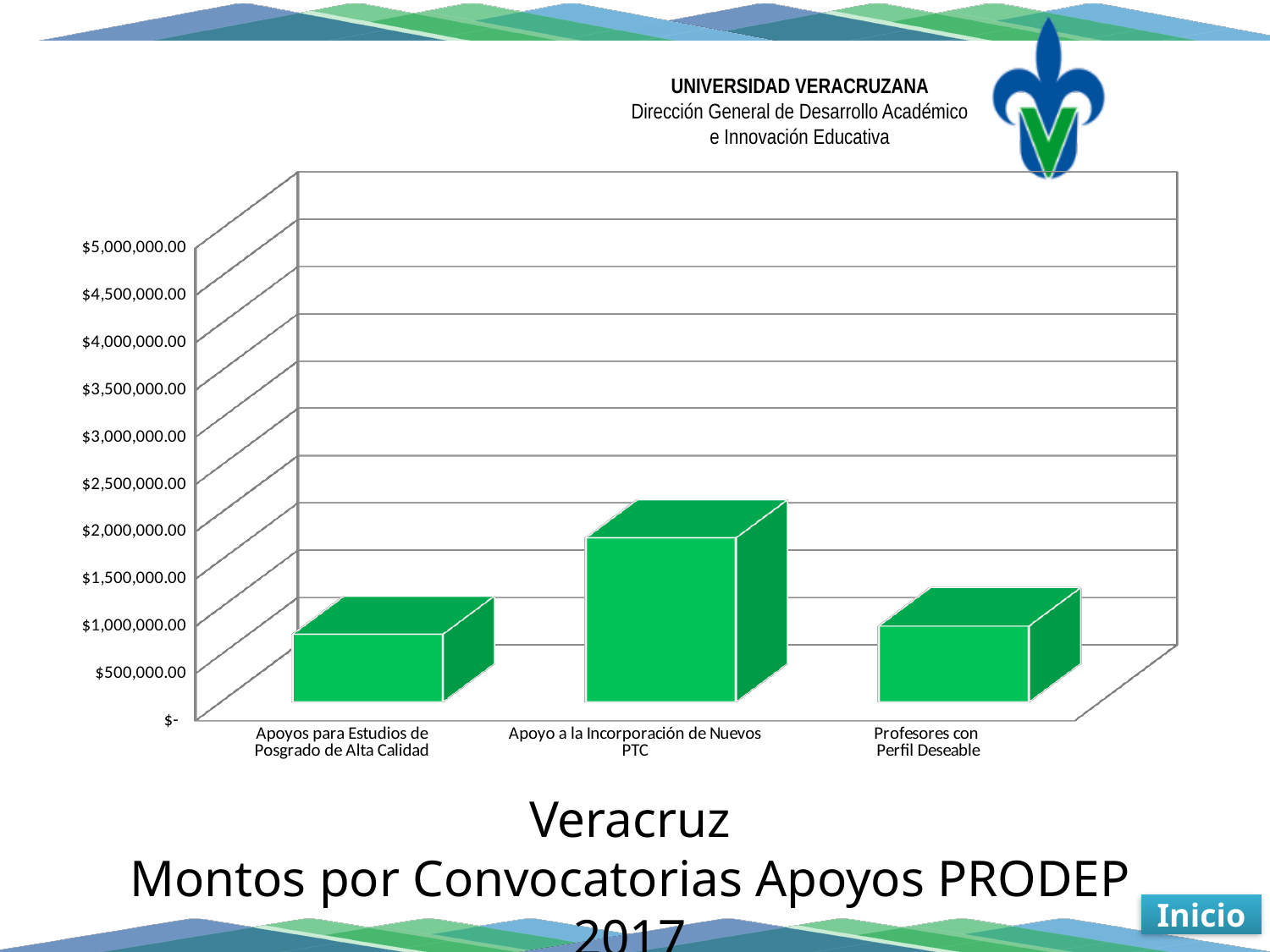
Is the value for Profesores con Perfil Deseable greater or less than $1,500,000.00? less How many categories are plotted in the chart? 3 Is the value for Apoyo a la Incorporación de Nuevos PTC greater or less than $3,000,000.00? less Is the value for Apoyo a la Incorporación de Nuevos PTC greater or less than $1,000,000.00? greater What colour are the bars in the chart? green What kind of chart is shown on the slide? bar chart Which category has the highest value in the chart? Apoyo a la Incorporación de Nuevos PTC What is the highest tick value shown on the vertical axis of the chart? $5,000,000.00 Which is larger: the value for Apoyos para Estudios de Posgrado de Alta Calidad or the value for Apoyo a la Incorporación de Nuevos PTC? Apoyo a la Incorporación de Nuevos PTC Which is larger: the value for Apoyo a la Incorporación de Nuevos PTC or the value for Profesores con Perfil Deseable? Apoyo a la Incorporación de Nuevos PTC